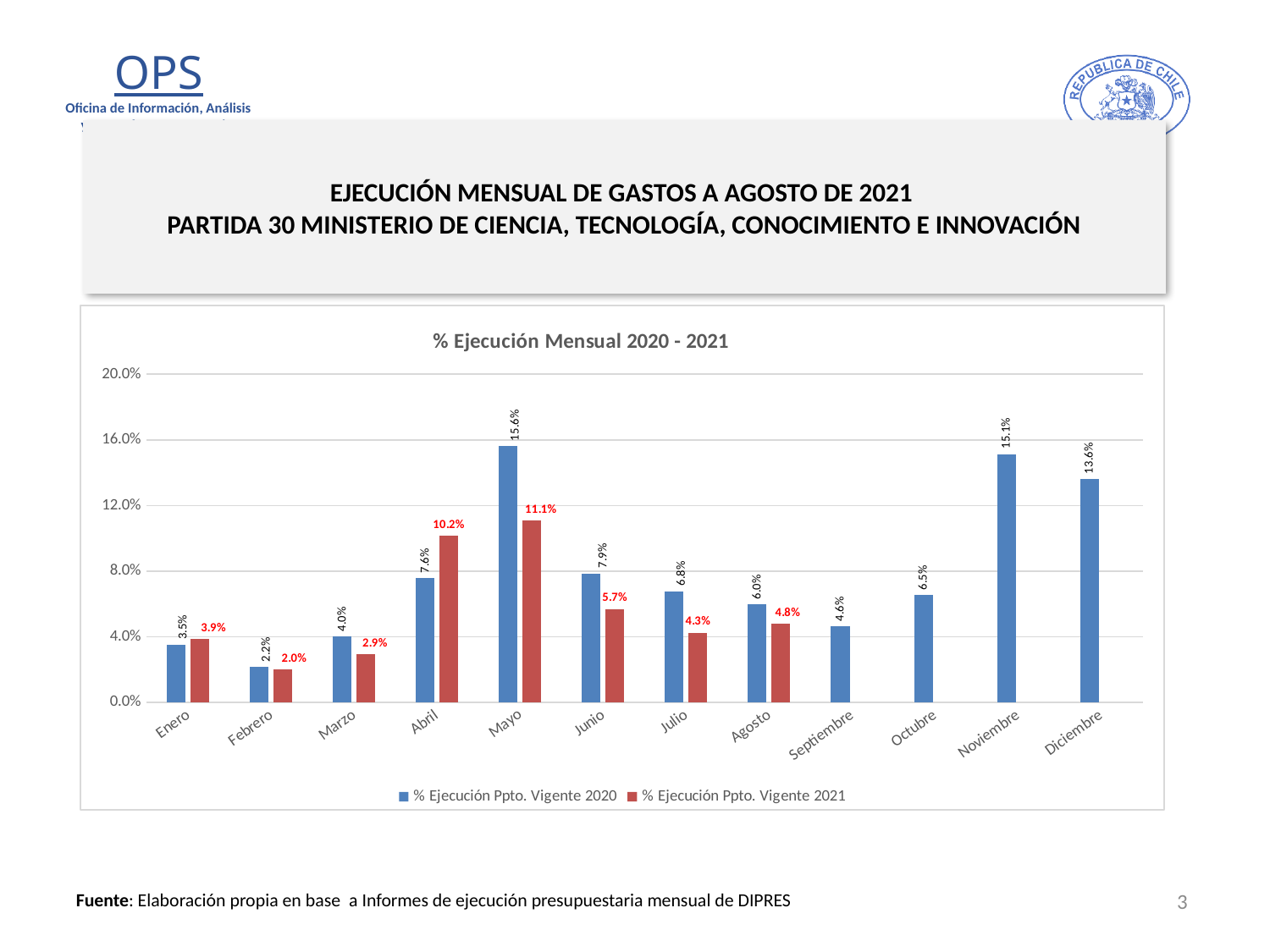
What is the difference between the 2020 and 2021 values for Mayo? 4.5% What is the value for Mayo in the % Ejecución Ppto. Vigente 2020 series? 15.6% Which month has the lowest value in the % Ejecución Ppto. Vigente 2021 series? Febrero What is the title of the chart? % Ejecución Mensual 2020 - 2021 Which is larger for Abril: the 2020 value or the 2021 value? 2021 value (10.2%) Is the value for Noviembre in the 2020 series greater or less than 12.0%? greater Do the 2021 series values rise or fall from Mayo to Julio? Fall How many months have a value plotted for the % Ejecución Ppto. Vigente 2021 series? 8 Which month has the highest value in the % Ejecución Ppto. Vigente 2020 series? Mayo How many series does the legend list? 2 What is the value for Abril in the % Ejecución Ppto. Vigente 2021 series? 10.2% What kind of chart is shown on the slide? Bar chart